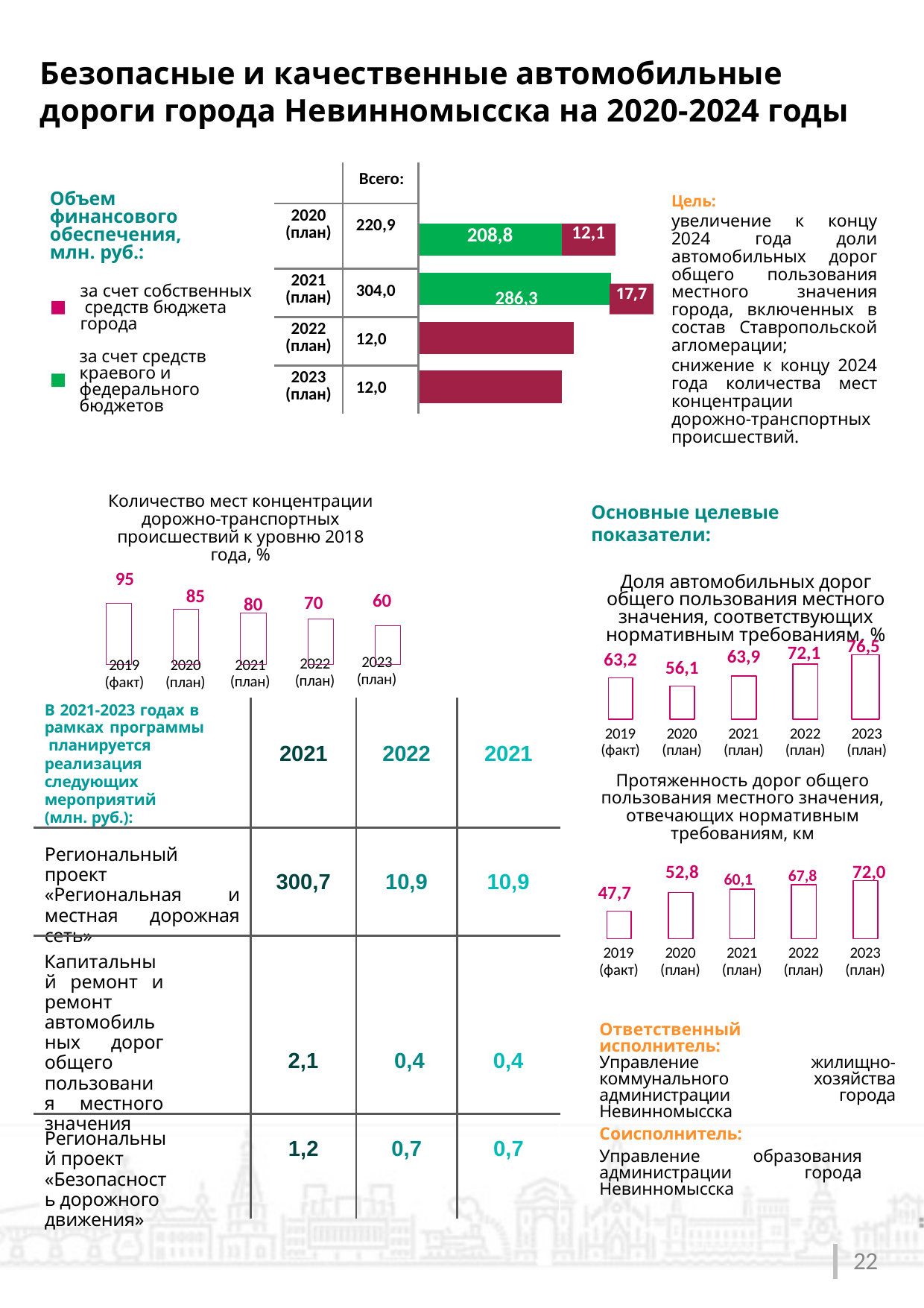
In the financing chart (Объем финансового обеспечения), what is the total (Всего) for 2021 (план)? 304,0 In the financing chart (Объем финансового обеспечения), what is the value for 2020 (план) from regional and federal budgets (green segment)? 208,8 In the chart 'Протяженность дорог общего пользования местного значения, отвечающих нормативным требованиям, км', what is the difference between 2023 (план) and 2019 (факт)? 24,3 In the financing chart (Объем финансового обеспечения), what is the difference between the city budget amounts for 2021 (план) and 2020 (план)? 5,6 In the chart 'Доля автомобильных дорог общего пользования местного значения, соответствующих нормативным требованиям, %', which year has the highest value? 2023 (план) In the chart 'Доля автомобильных дорог общего пользования местного значения, соответствующих нормативным требованиям, %', what is the value for 2020 (план)? 56,1 In the chart 'Протяженность дорог общего пользования местного значения, отвечающих нормативным требованиям, км', which year has the lowest value? 2019 (факт) In the chart 'Количество мест концентрации дорожно-транспортных происшествий к уровню 2018 года, %', do the values rise or fall from 2019 to 2023? fall In the financing chart (Объем финансового обеспечения), how many series does the legend list? 2 In the chart 'Количество мест концентрации дорожно-транспортных происшествий к уровню 2018 года, %', how many years are shown? 5 In the chart 'Количество мест концентрации дорожно-транспортных происшествий к уровню 2018 года, %', what is the value for 2023 (план)? 60 What kind of chart is used for 'Протяженность дорог общего пользования местного значения, отвечающих нормативным требованиям, км'? bar chart